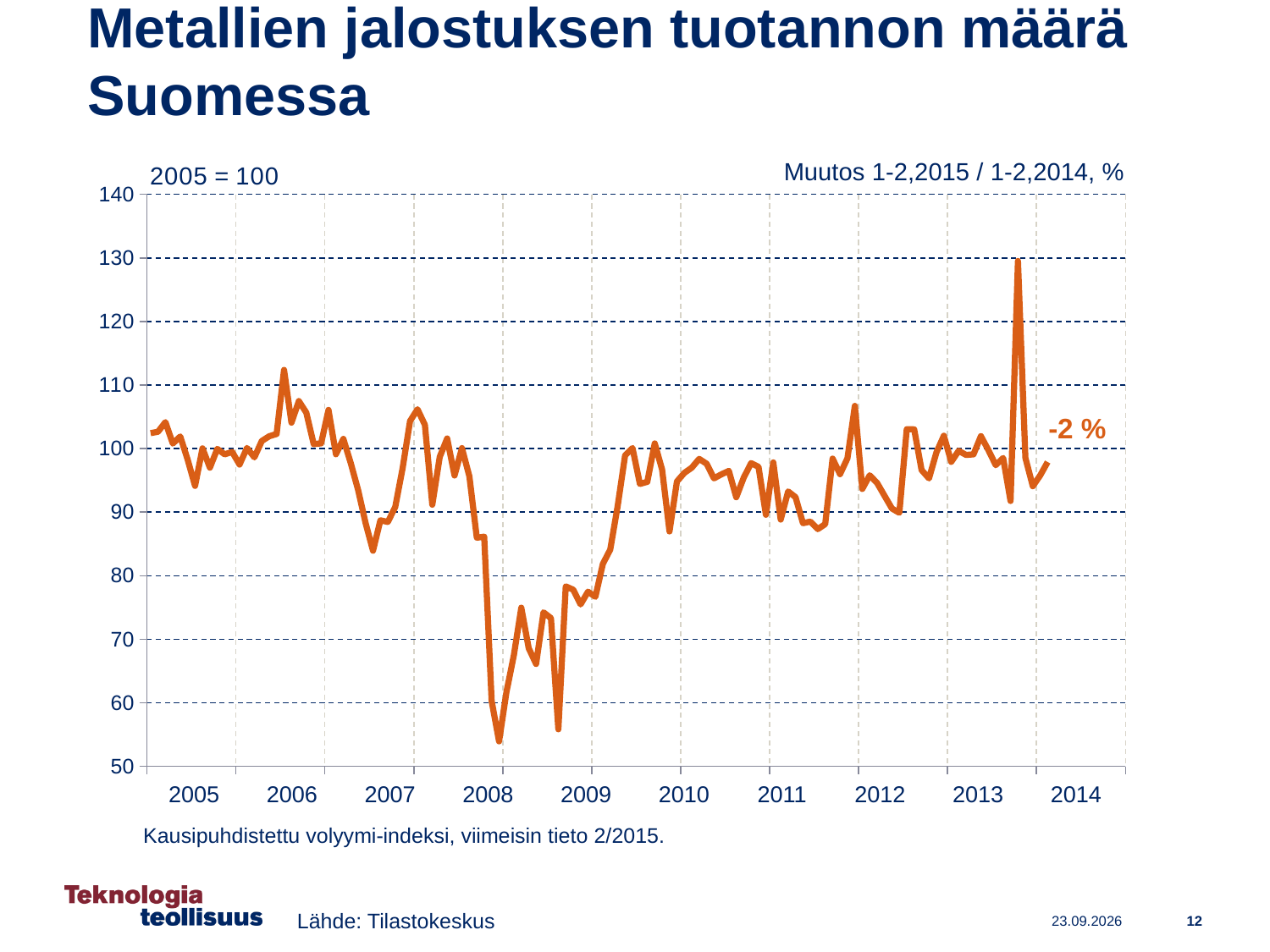
Is the lowest value of the line in 2008 greater or less than 60? less What is the change 1-2,2015 / 1-2,2014 shown on the chart? -2 % What is the title of the chart on the slide? Metallien jalostuksen tuotannon määrä Suomessa In which year does the line reach its highest point? 2014 Do the values rise or fall from the start of 2009 to the end of 2009? rise How many data series are plotted on the chart? 1 Is the value at the start of 2005 greater or less than 90? greater What is the highest value shown on the vertical axis? 140 What kind of chart is shown on the slide? line chart Do the values rise or fall from mid-2008 to the start of 2009? fall In which year does the line reach its lowest point? 2008